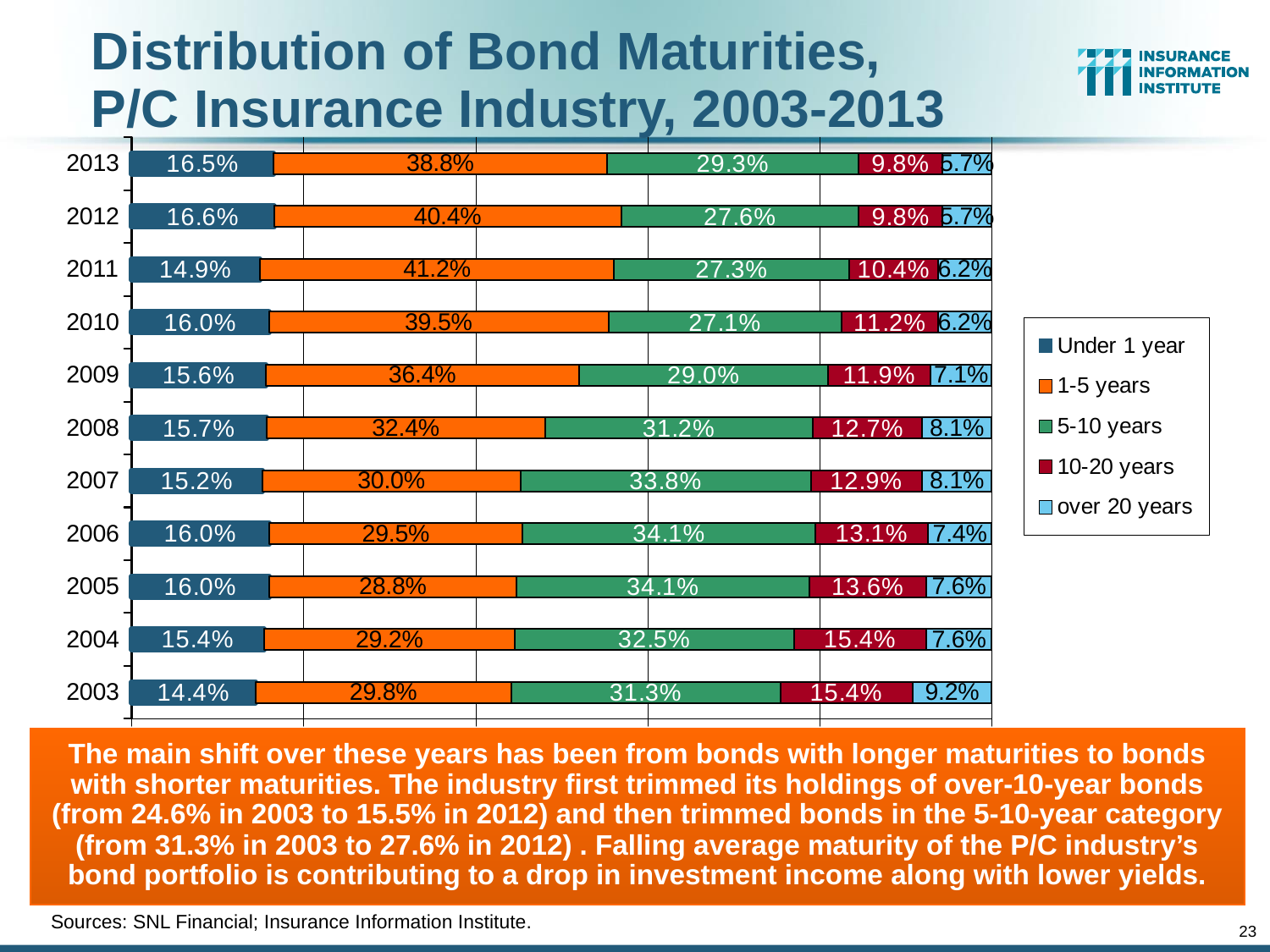
What was the Under 1 year share in 2003? 14.4% How many maturity categories does the legend list? 5 In which year was the 1-5 years share the lowest? 2005 What kind of chart is this? Stacked bar chart What was the combined share of 10-20 years and over 20 years bonds in 2003? 24.6% What share of bonds had a 1-5 year maturity in 2011? 41.2% What was the 5-10 years share in 2006? 34.1% In which year was the over 20 years share the highest? 2003 How many years are shown in the chart? 11 Which year had a larger 1-5 years share, 2008 or 2009? 2009 By how many percentage points did the 5-10 years share fall from 2003 to 2012? 3.7 percentage points In which year was the 1-5 years share the highest? 2011